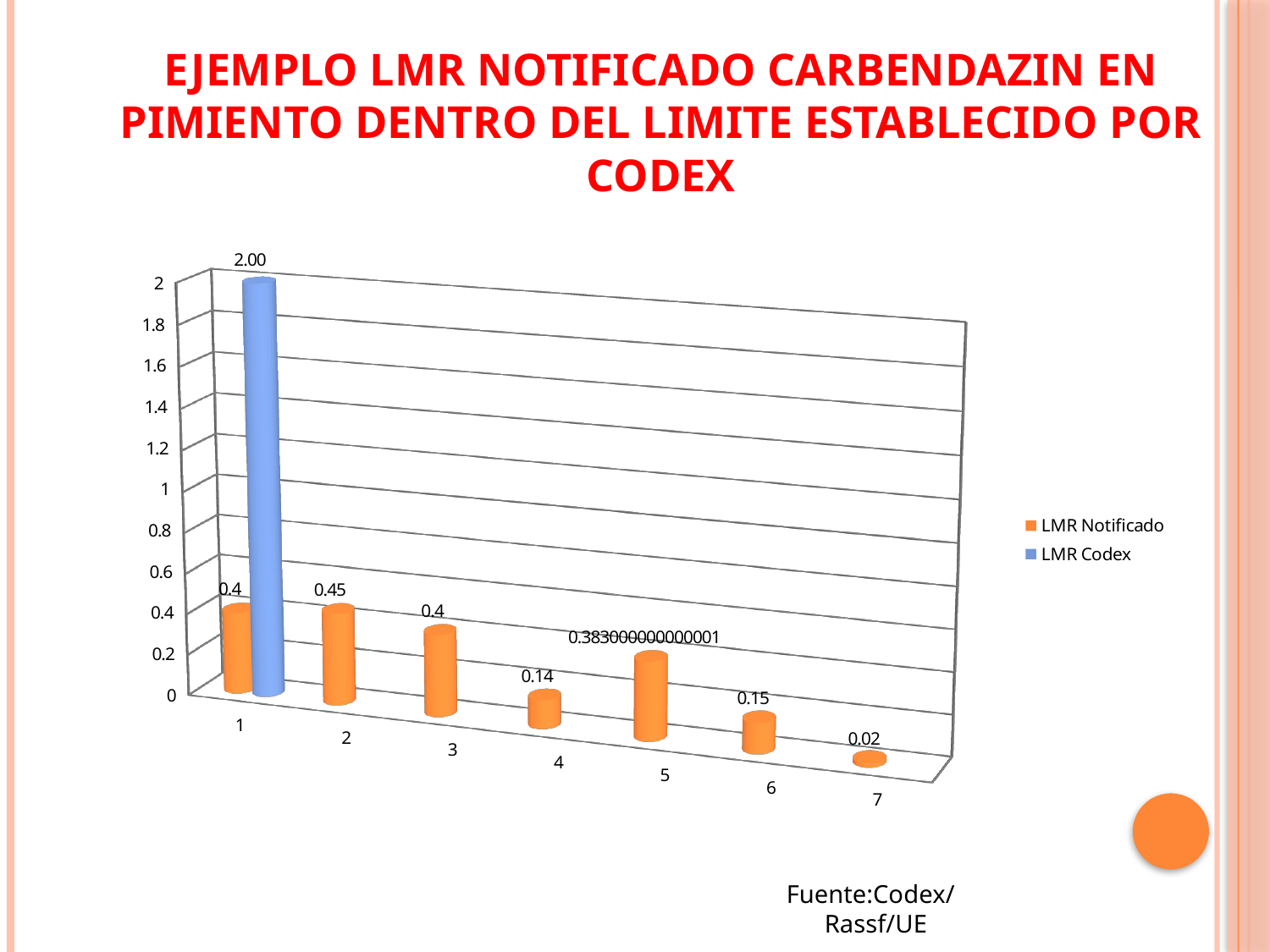
Which series is shown in blue in the legend? LMR Codex What is the difference between the LMR Notificado values for category 2 and category 7? 0.43 What is the LMR Notificado value for category 7? 0.02 How many series does the legend list? 2 What is the LMR Notificado value for category 4? 0.14 Which category has the lowest LMR Notificado value? 7 Which is larger, the LMR Notificado value for category 4 or for category 6? category 6 Which category has the highest LMR Notificado value? 2 How many categories are shown on the x axis? 7 What is the LMR Notificado value for category 2? 0.45 What kind of chart is shown on the slide? bar chart What is the LMR Codex value shown for category 1? 2.00